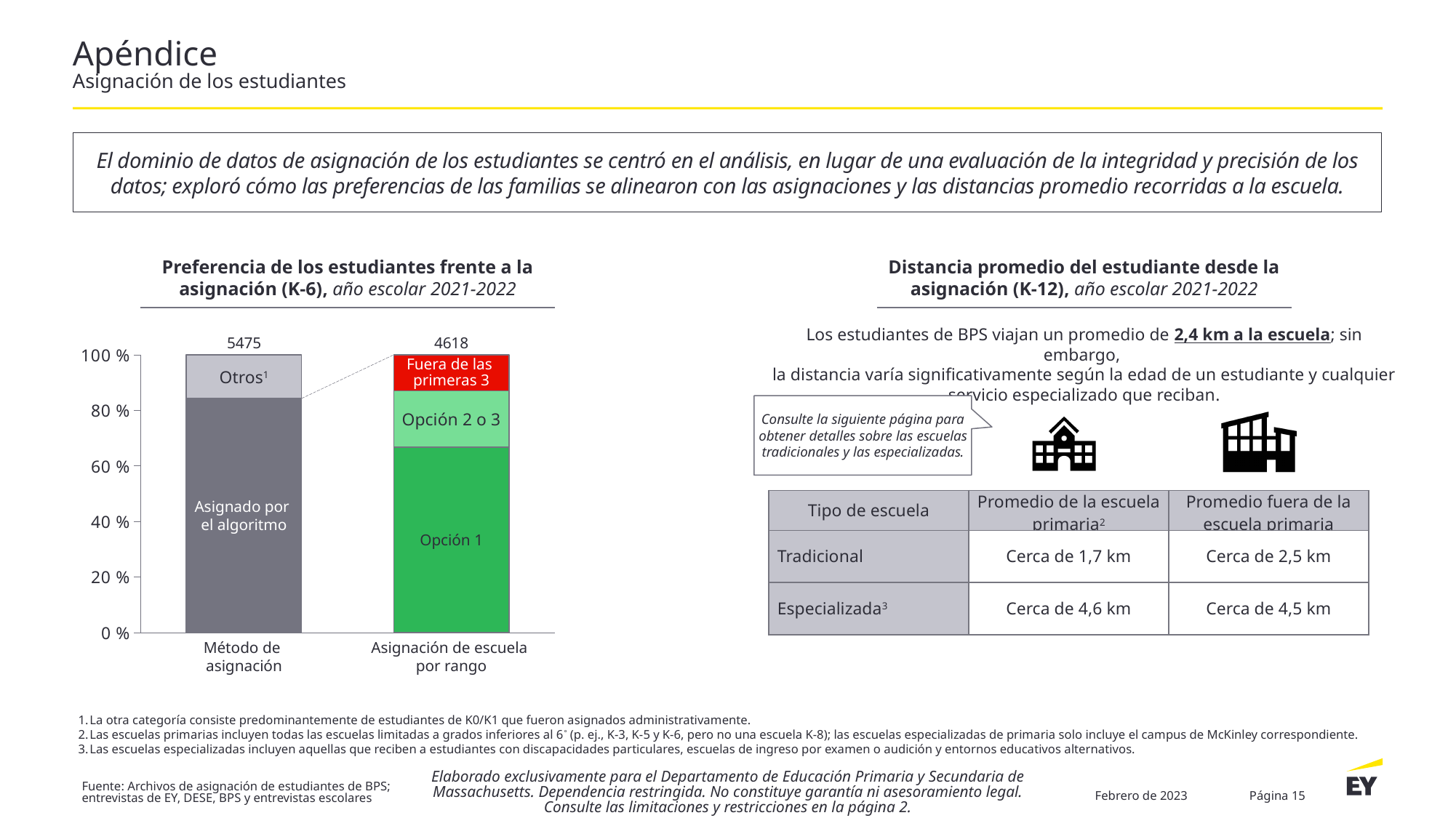
Which bar has the larger printed total, 'Método de asignación' or 'Asignación de escuela por rango'? Método de asignación Is the share of the 'Opción 1' segment in the 'Asignación de escuela por rango' bar greater or less than 60 %? greater Which segment of the 'Asignación de escuela por rango' bar is coloured red? Fuera de las primeras 3 What is the difference between the printed totals of the 'Método de asignación' bar and the 'Asignación de escuela por rango' bar? 857 Is the share of the 'Fuera de las primeras 3' segment greater or less than 20 %? less What total is printed above the 'Asignación de escuela por rango' bar? 4618 What kind of chart is shown on the left of the slide? bar chart How many bars (categories) are plotted in the chart 'Preferencia de los estudiantes frente a la asignación (K-6)'? 2 Is the share of the 'Otros' segment in the 'Método de asignación' bar greater or less than 20 %? less Which segment is the largest in the 'Método de asignación' bar? Asignado por el algoritmo What total is printed above the 'Método de asignación' bar? 5475